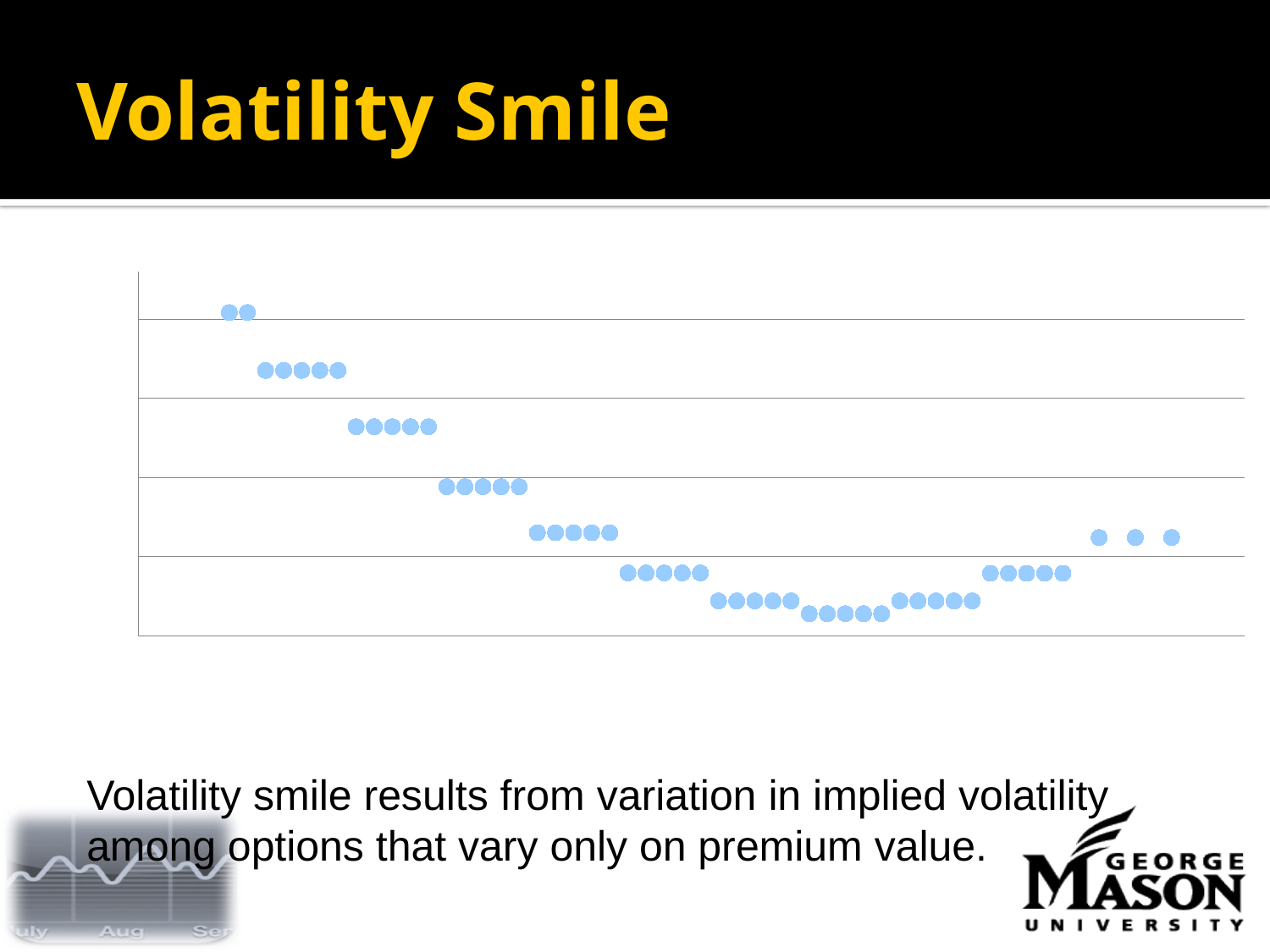
Do the plotted points fall or rise as you move from left to right across the first half of the chart? fall What colour are the plotted markers in the chart? light blue What overall shape do the plotted points form across the chart? a U-shape (smile) Does the chart display a legend? No What kind of chart is shown on the slide? scatter chart Do the plotted points rise or fall along the x axis in the right-hand portion of the chart? rise